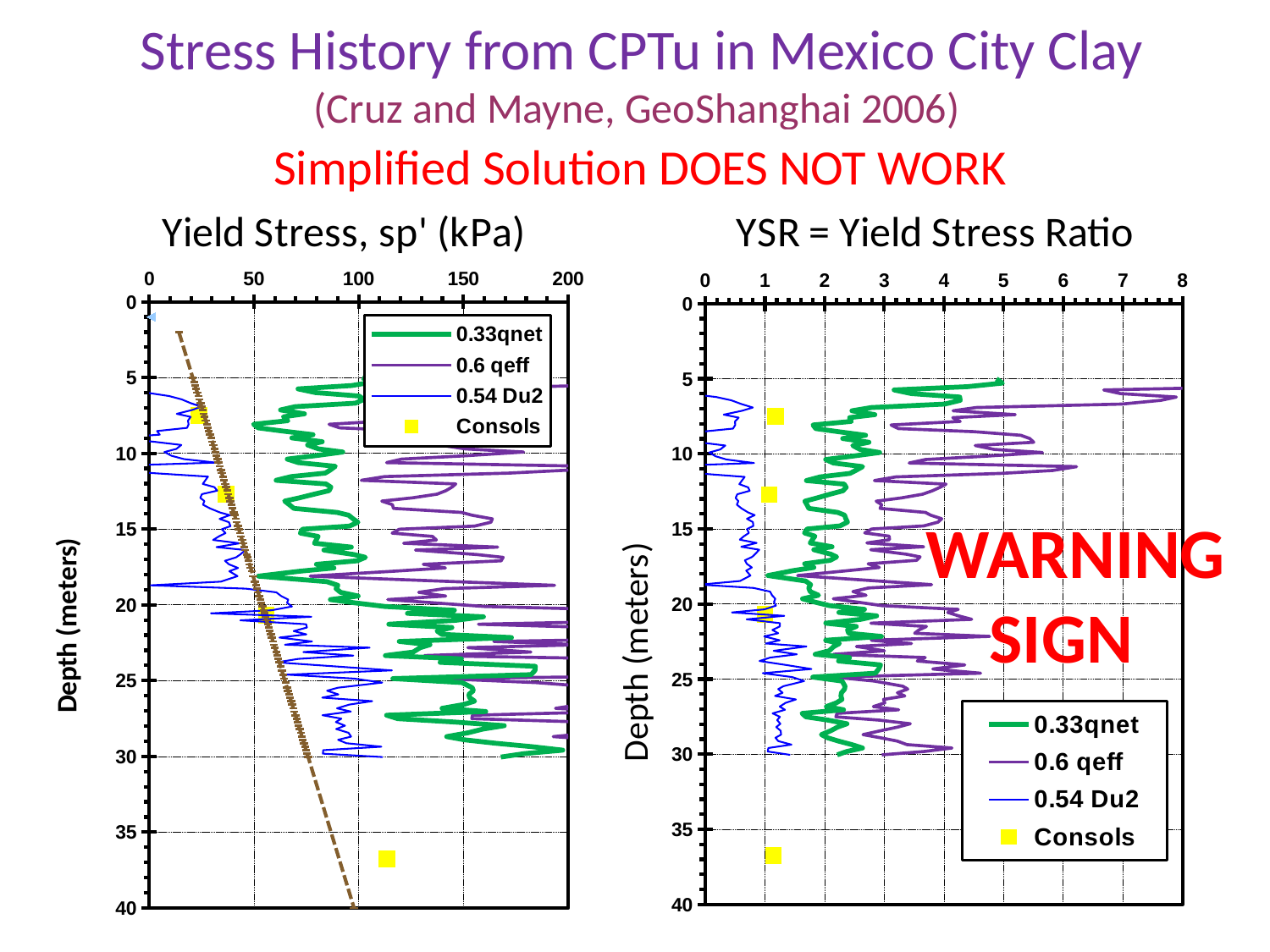
On the left chart "Yield Stress, sp' (kPa)", is the 0.33qnet value at a depth of 5 meters greater or less than 100? less On the right chart "YSR = Yield Stress Ratio", is the 0.54 Du2 value at a depth of 25 meters greater or less than 2? less On the right chart "YSR = Yield Stress Ratio", at a depth of 25 meters, which series has the larger value: 0.33qnet or 0.54 Du2? 0.33qnet What is the maximum value shown on the horizontal axis of the right chart "YSR = Yield Stress Ratio"? 8 On the left chart "Yield Stress, sp' (kPa)", at a depth of 10 meters, which series has the larger value: 0.6 qeff or 0.54 Du2? 0.6 qeff What are the legend entries on the left chart "Yield Stress, sp' (kPa)"? 0.33qnet, 0.6 qeff, 0.54 Du2, Consols On the left chart "Yield Stress, sp' (kPa)", is the 0.6 qeff value at a depth of 10 meters greater or less than 100? greater How many series does the legend of the right chart "YSR = Yield Stress Ratio" list? 4 What kind of chart is the left chart titled "Yield Stress, sp' (kPa)"? line chart